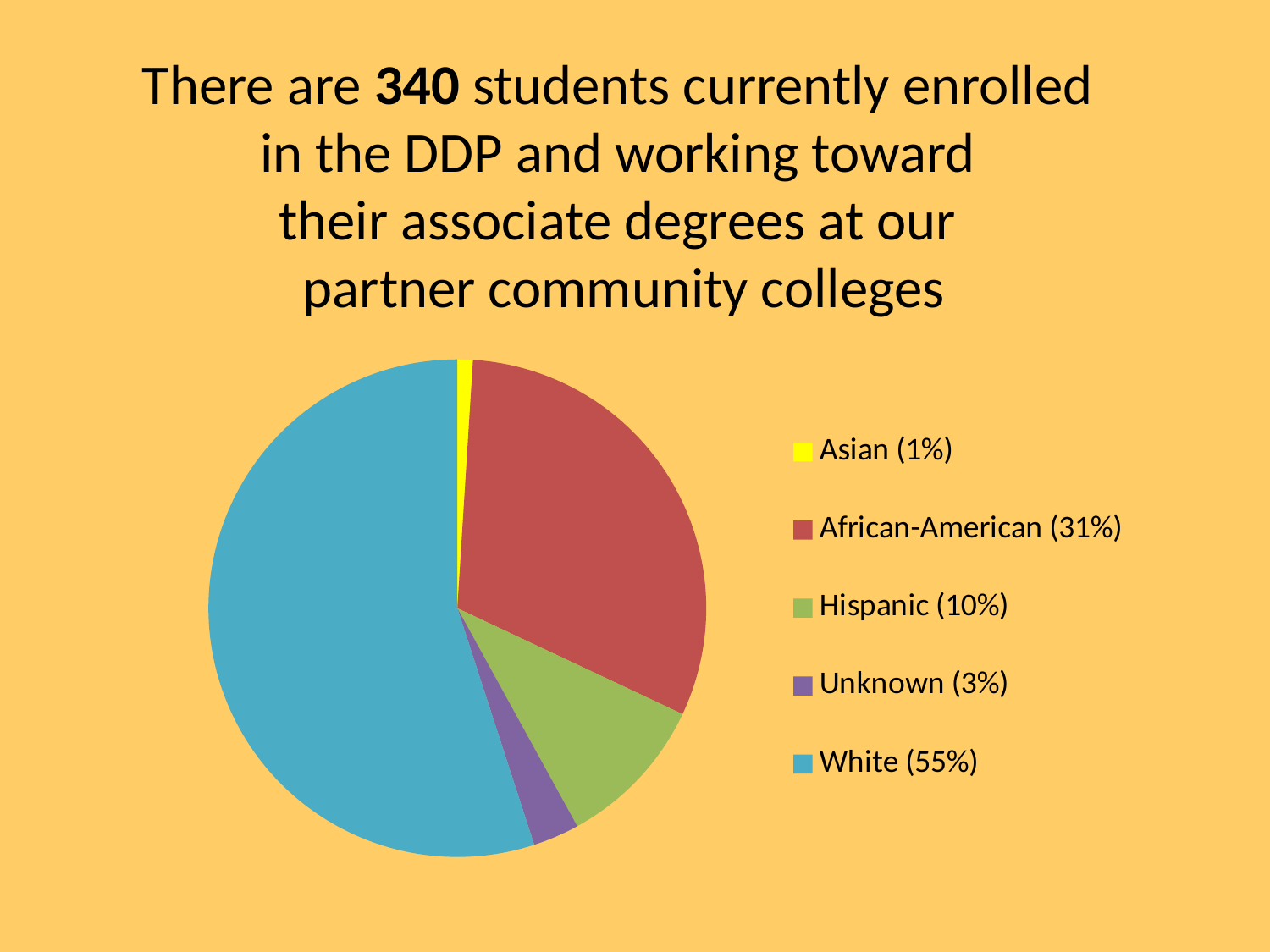
What share of the pie does African-American represent? 31% What kind of chart is shown on the slide? pie chart What share of the pie does Unknown represent? 3% Which slice is larger, Hispanic or Unknown? Hispanic What share of the pie does Asian represent? 1% What colour is the slice for African-American? red What is the difference in percentage points between the White and African-American slices? 24 Which category has the largest slice of the pie? White How many categories does the pie chart show? 5 Which category has the smallest slice of the pie? Asian